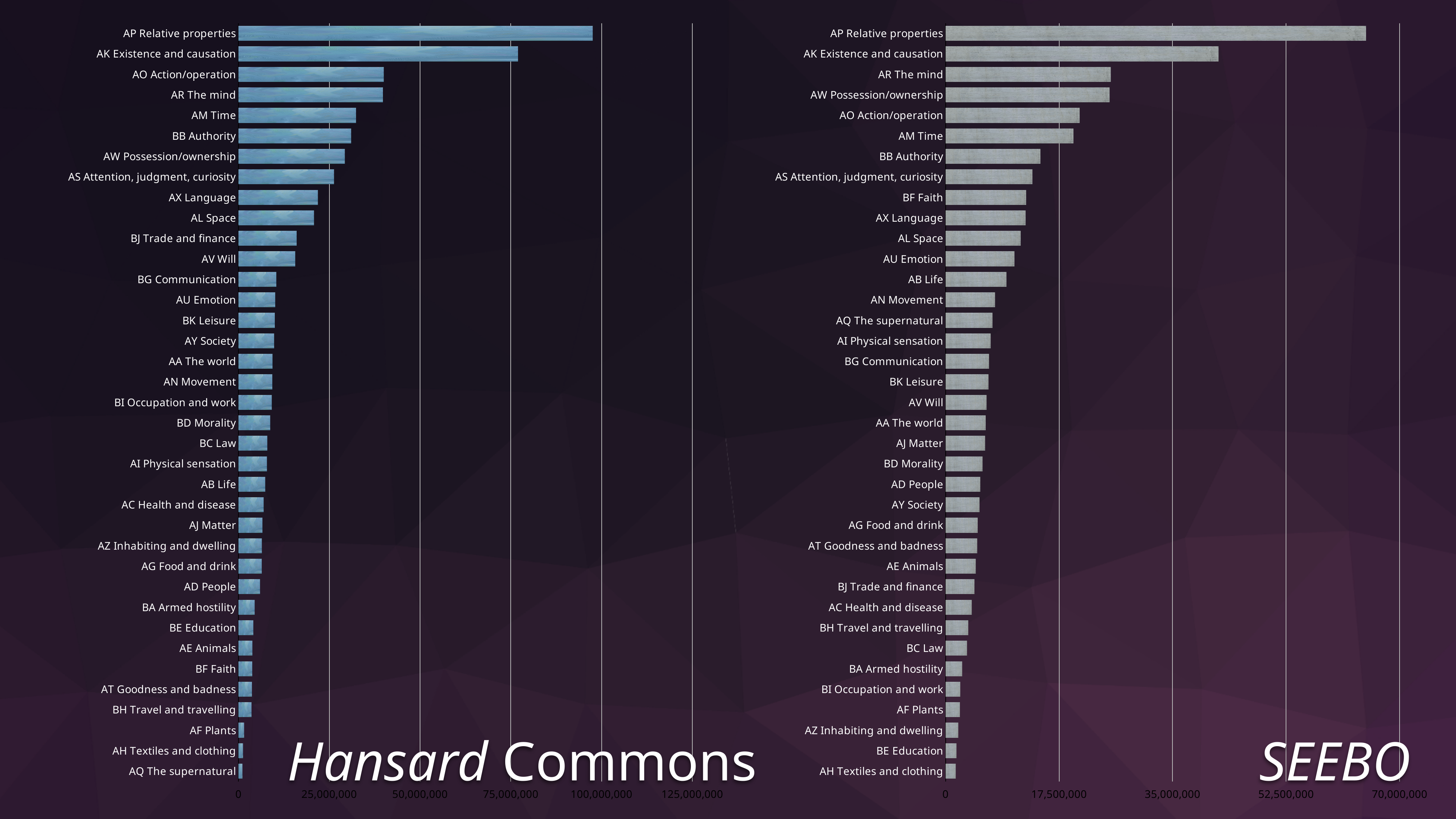
In the SEEBO chart, which category has the lowest value? AH Textiles and clothing In the Hansard Commons chart, is the value for AP Relative properties greater or less than 75,000,000? greater How many categories are plotted in the SEEBO chart? 37 In the Hansard Commons chart, which is larger, AM Time or AX Language? AM Time In the SEEBO chart, is the value for AP Relative properties greater or less than 52,500,000? greater What type of chart is the Hansard Commons chart on the left? bar chart In the Hansard Commons chart, which category has the lowest value? AQ The supernatural In the Hansard Commons chart, is the value for AX Language greater or less than 25,000,000? less In the Hansard Commons chart, which category has the highest value? AP Relative properties In the SEEBO chart, which category has the highest value? AP Relative properties